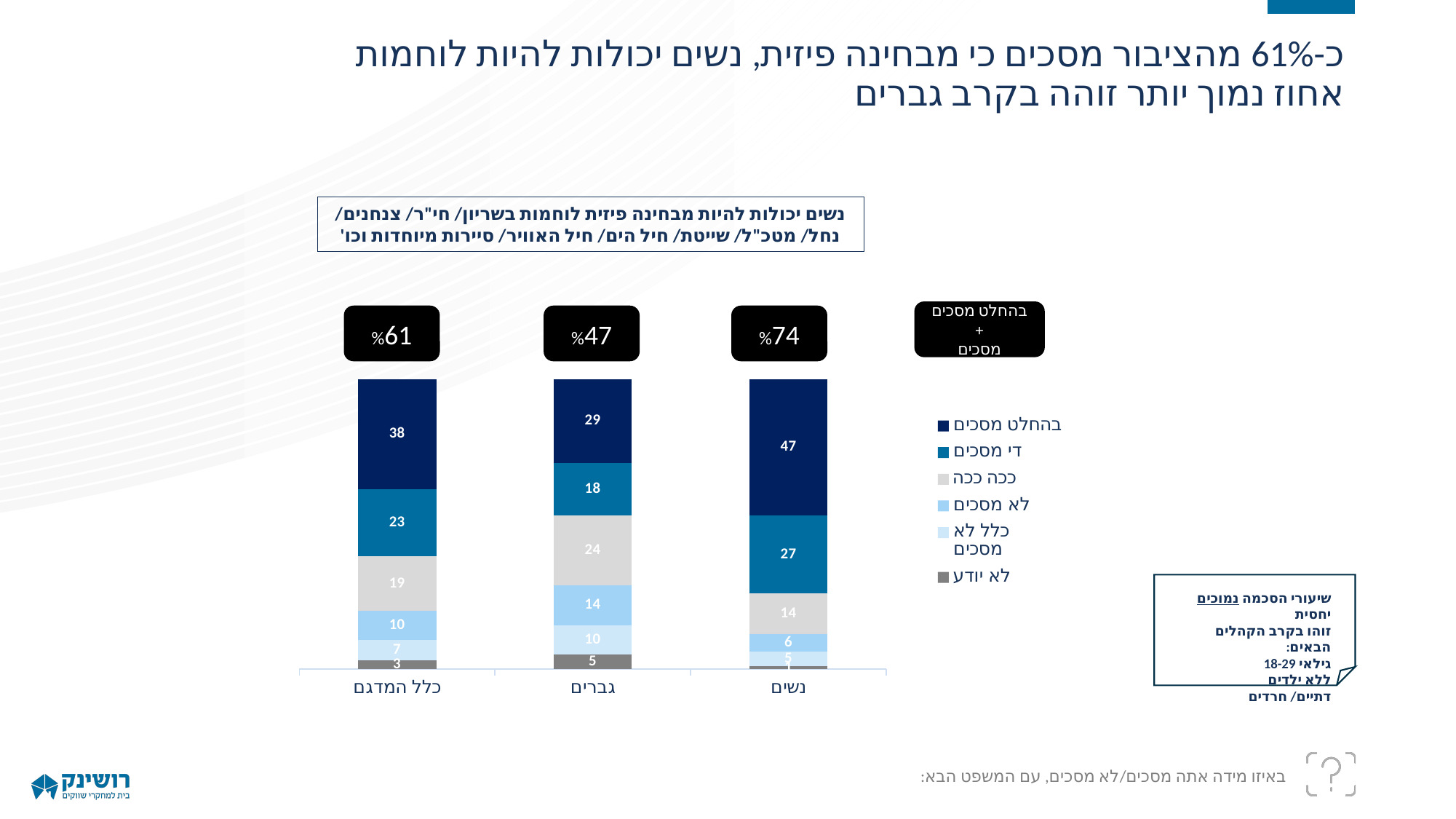
Which category has the lowest value for the בהחלט מסכים segment? גברים How many categories are shown along the x axis of the chart? 3 Which is larger: the לא מסכים value for גברים or for נשים? גברים Which category has the highest combined percentage shown above its bar? נשים What kind of chart is shown on the slide? stacked bar chart What is the total of the כלל המדגם stacked bar? 100 What is the difference between the בהחלט מסכים values for נשים and גברים? 18 What combined percentage (בהחלט מסכים + מסכים) is shown above the גברים bar? 47% How many series does the chart legend list? 6 What is the value of the ככה ככה segment for גברים? 24 What is the value of the בהחלט מסכים segment for נשים? 47 What is the value of the די מסכים segment for כלל המדגם? 23